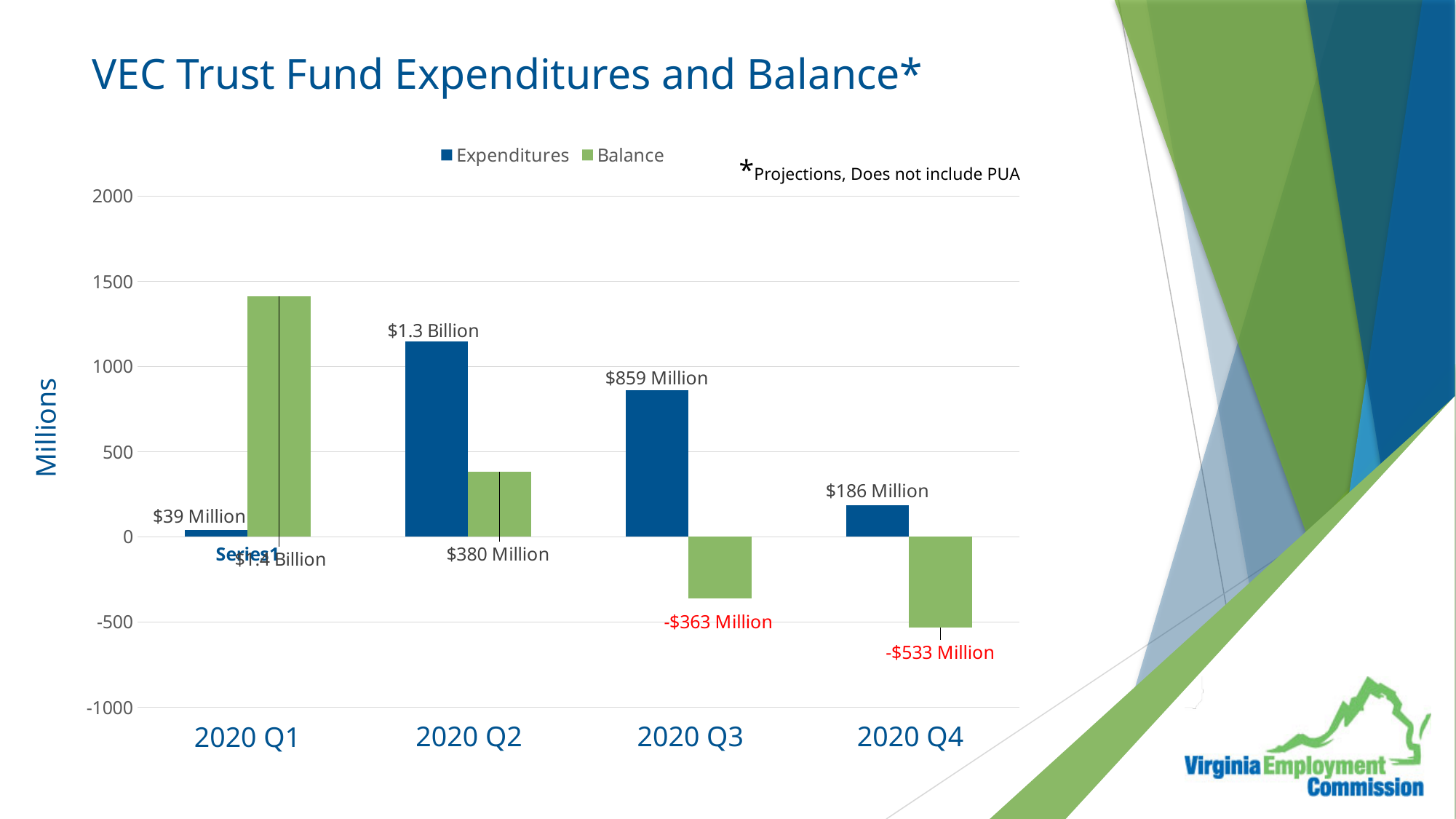
In which quarter are Expenditures highest? 2020 Q2 What is the Expenditures value for 2020 Q1? $39 Million What is the Expenditures value for 2020 Q3? $859 Million Does the Balance rise or fall from 2020 Q1 to 2020 Q4? Fall What kind of chart is shown on the slide? Bar chart How many series does the legend list? 2 What is the Balance value for 2020 Q2? $380 Million What is the difference between Expenditures in 2020 Q3 and 2020 Q4? $673 Million What is the Balance value for 2020 Q4? -$533 Million Which is larger, the Balance in 2020 Q1 or the Balance in 2020 Q2? 2020 Q1 How many quarters are shown on the x axis? 4 In which quarter is the Balance lowest? 2020 Q4